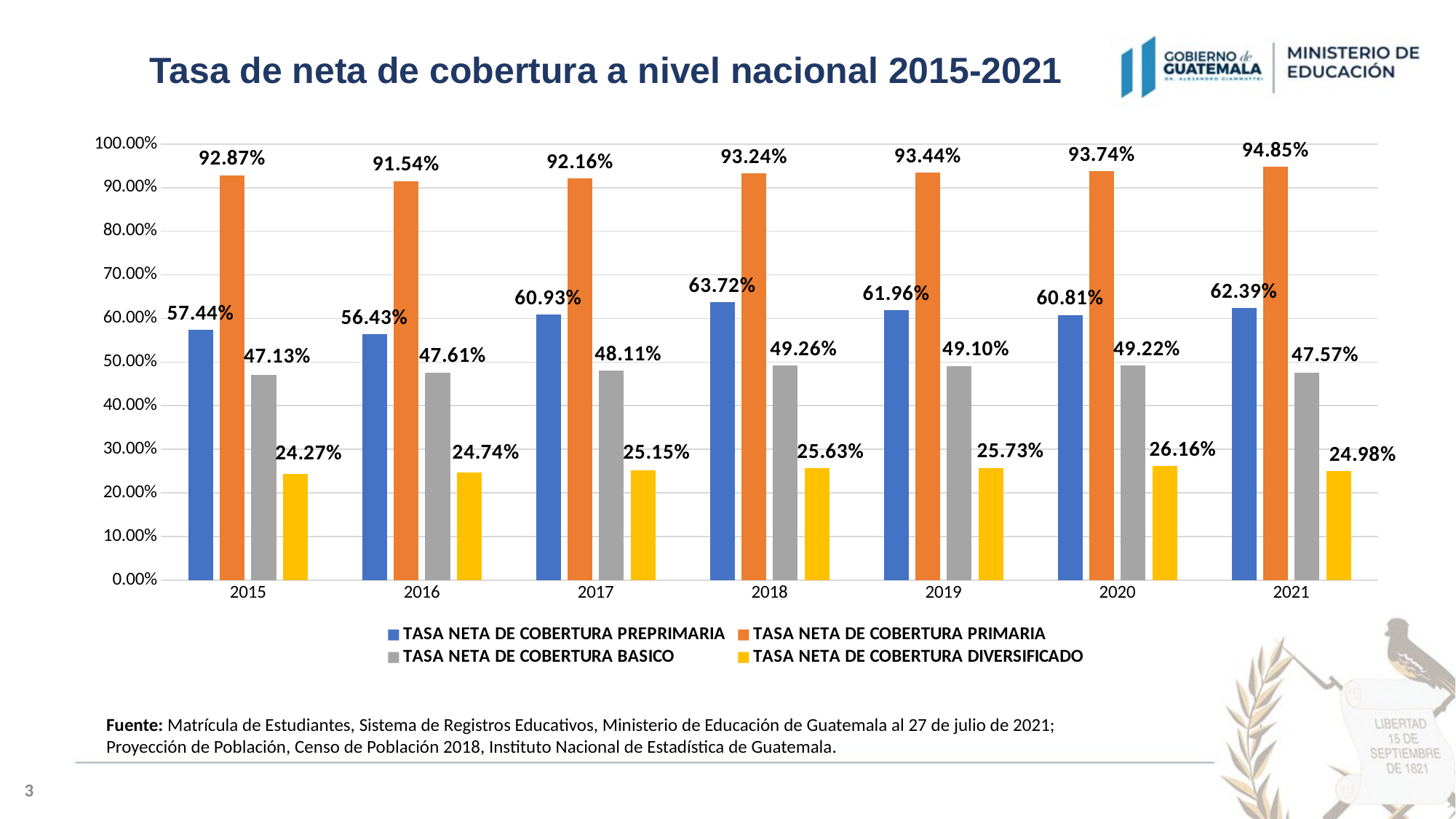
In which year is TASA NETA DE COBERTURA PRIMARIA highest? 2021 How many series does the legend list? 4 What is the value for TASA NETA DE COBERTURA PREPRIMARIA in 2018? 63.72% What is the value for TASA NETA DE COBERTURA BASICO in 2019? 49.10% Which is larger: TASA NETA DE COBERTURA DIVERSIFICADO in 2020 or in 2021? 2020 What is the difference between TASA NETA DE COBERTURA PRIMARIA in 2021 and in 2015? 1.98% In which year is TASA NETA DE COBERTURA PREPRIMARIA lowest? 2016 Which colour represents TASA NETA DE COBERTURA BASICO in the chart? Gray What kind of chart is shown on the slide? Bar chart How many years are shown on the x axis? 7 What is the value for TASA NETA DE COBERTURA DIVERSIFICADO in 2015? 24.27% What is the value for TASA NETA DE COBERTURA PRIMARIA in 2021? 94.85%